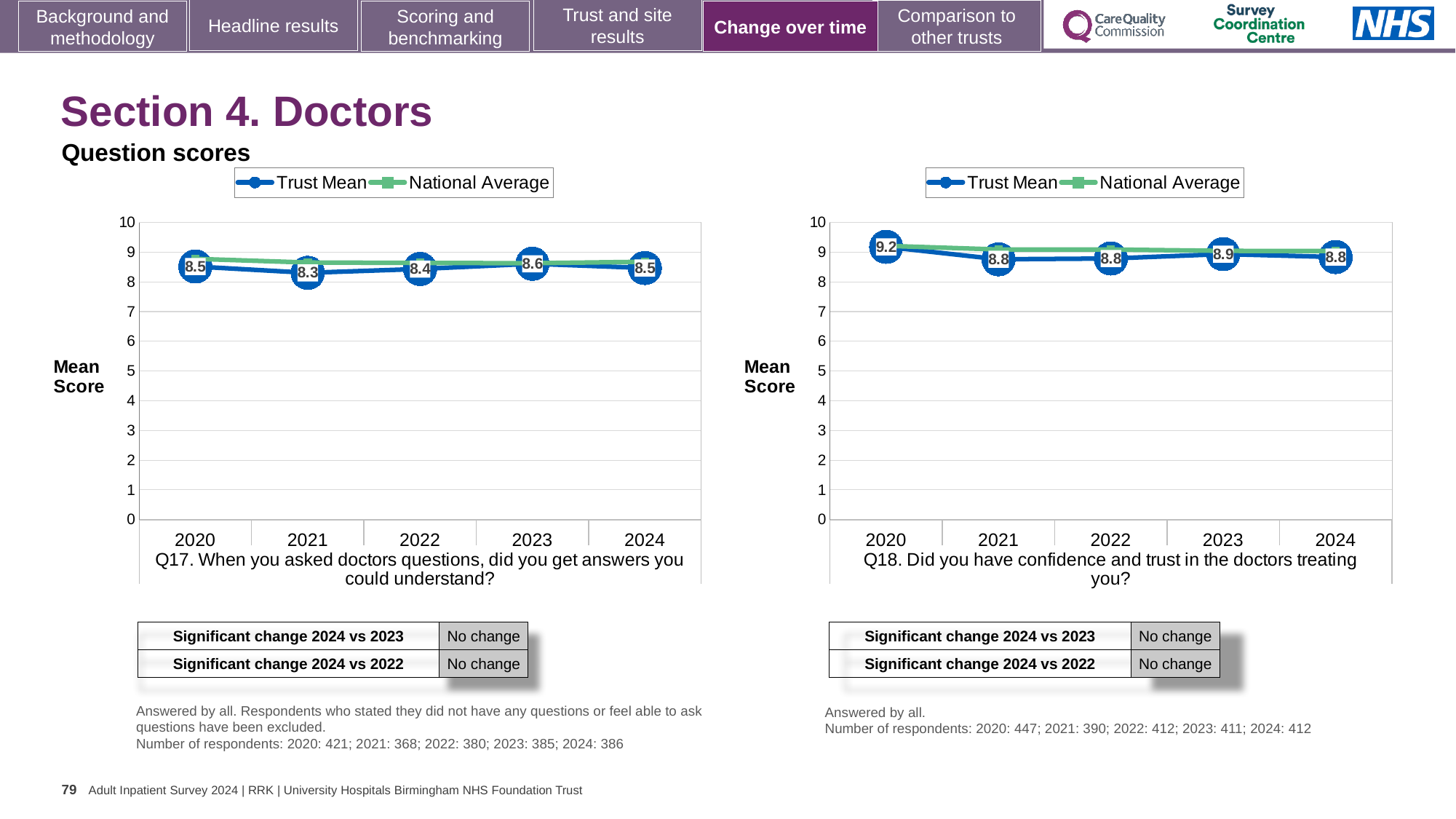
In the Q18 chart (right), what is the difference between the Trust Mean score in 2020 and in 2021? 0.4 In the Q17 chart (left), is the Trust Mean score higher in 2023 or in 2021? 2023 In the Q17 chart (left), what is the Trust Mean score for 2021? 8.3 How many series does the legend of the Q17 chart (left) list? 2 In the Q18 chart (right), what is the Trust Mean score for 2024? 8.8 In the Q17 chart (left), is the Trust Mean value for 2022 greater or less than 9? less How many years are plotted on the x axis of the Q18 chart (right)? 5 What type of chart is used for Q18 (right)? Line chart In the Q17 chart (left), what is the Trust Mean score for 2023? 8.6 In the Q18 chart (right), what is the Trust Mean score for 2020? 9.2 In the Q18 chart (right), which year has the highest Trust Mean score? 2020 In the Q17 chart (left), which year has the lowest Trust Mean score? 2021